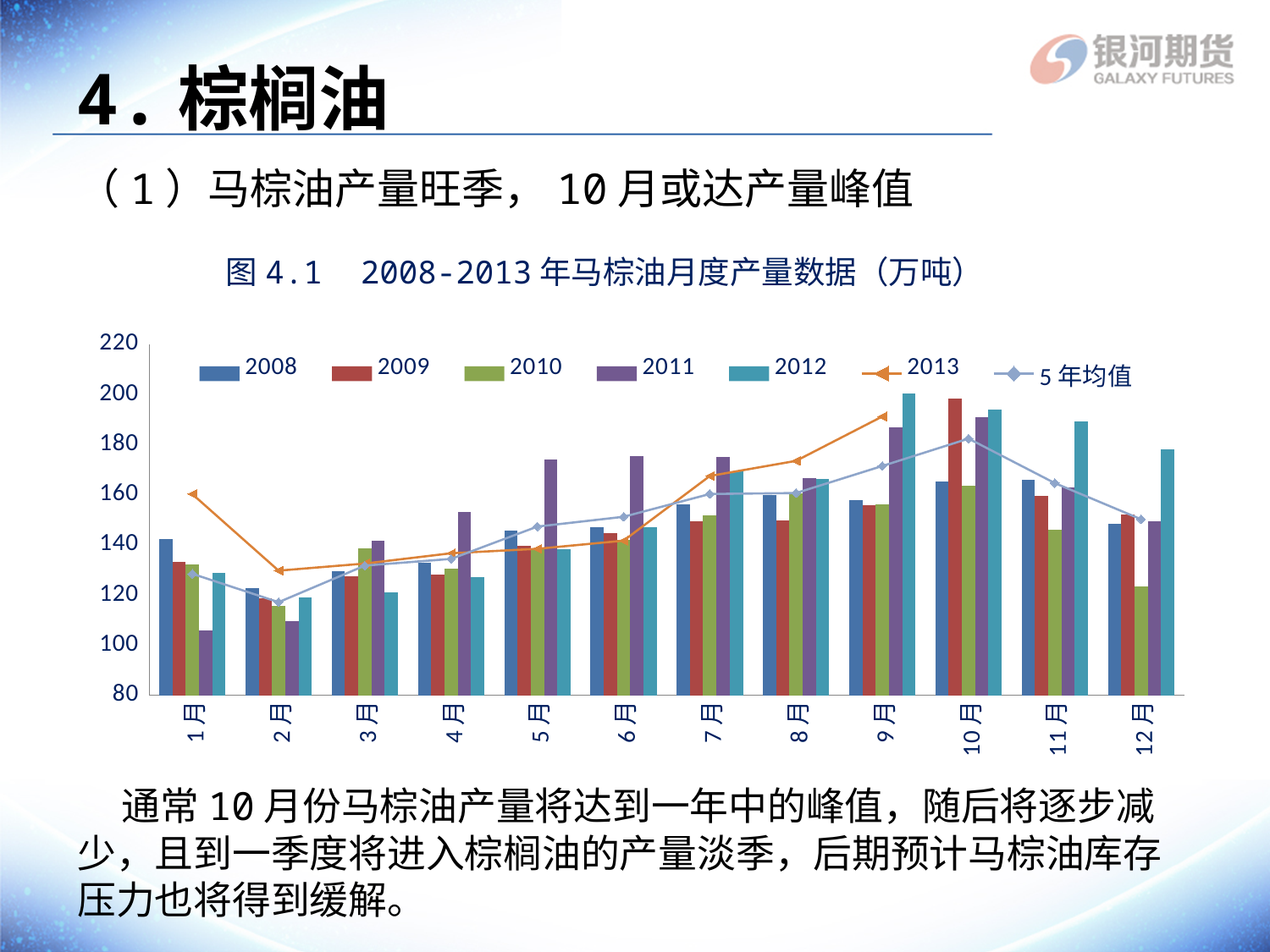
How many series does the chart legend list? 7 In which month does the 2013 line reach its highest point? 9月 In 12月, which is larger, the 2012 bar or the 2008 bar? 2012 Which series is drawn as the orange line in the chart? 2013 In which month does the 5年均值 line reach its highest point? 10月 Is the value for 2012 in 9月 greater or less than 180? greater Is the value for 2011 in 1月 greater or less than 120? less How many months are shown along the x axis of the chart? 12 In which month is the 2008 bar the lowest? 2月 What kind of chart is shown on the slide? A bar chart combined with line series In which month does the 5年均值 line reach its lowest point? 2月 What is the title of the chart? 图4.1 2008-2013年马棕油月度产量数据（万吨）